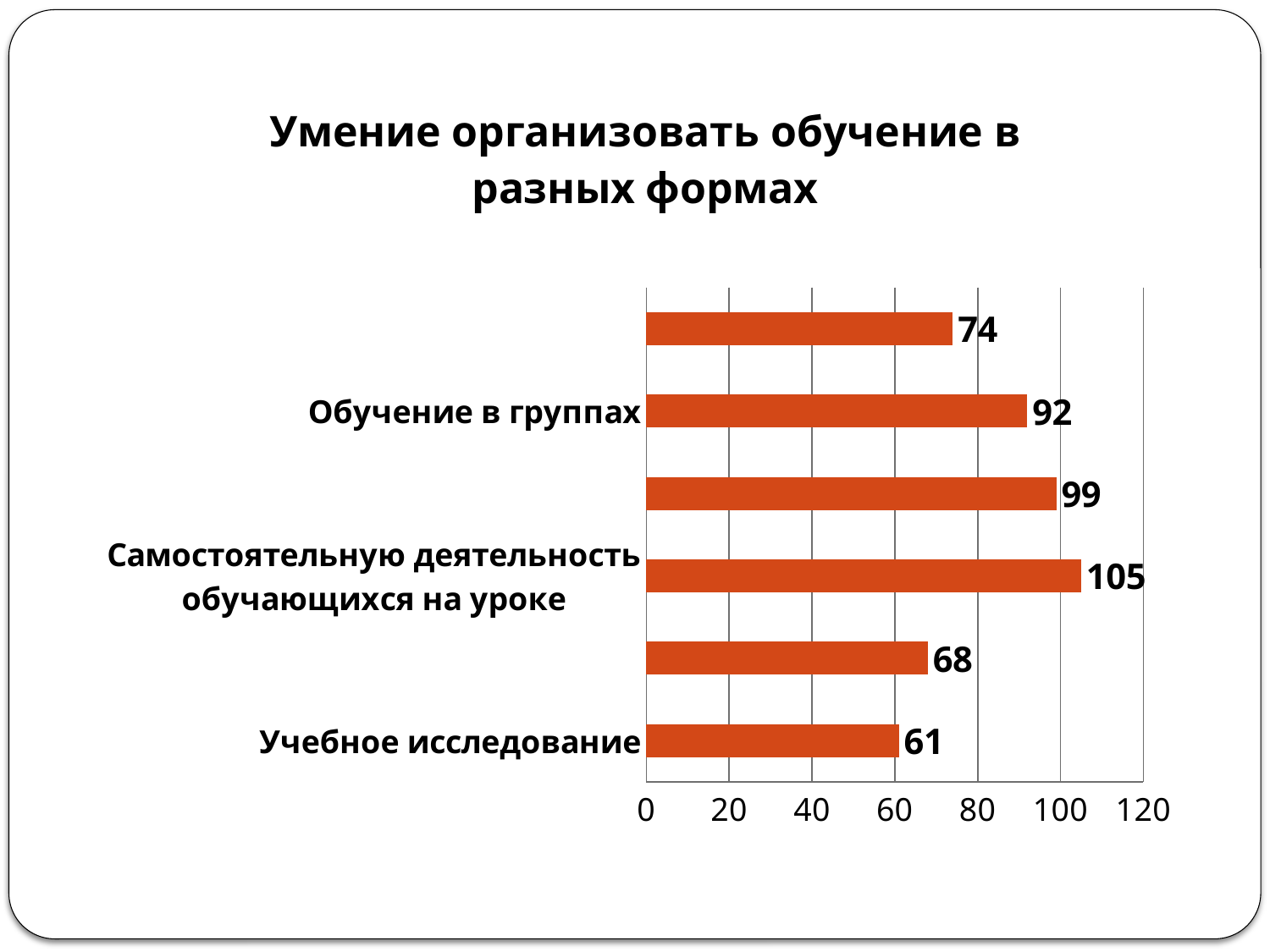
Which labelled category has the highest value? Самостоятельную деятельность обучающихся на уроке What is the value for Обучение в группах? 92 What is the difference between the values for Самостоятельную деятельность обучающихся на уроке and Обучение в группах? 13 What is the value for Учебное исследование? 61 What kind of chart is shown on the slide? bar chart What is the title of the chart? Умение организовать обучение в разных формах What is the value for Самостоятельную деятельность обучающихся на уроке? 105 What is the difference between the values for Обучение в группах and Учебное исследование? 31 Which is larger, the value for Обучение в группах or the value for Учебное исследование? Обучение в группах Which labelled category has the lowest value? Учебное исследование How many bars are plotted in the chart? 6 Is the value for Учебное исследование greater or less than 80? less